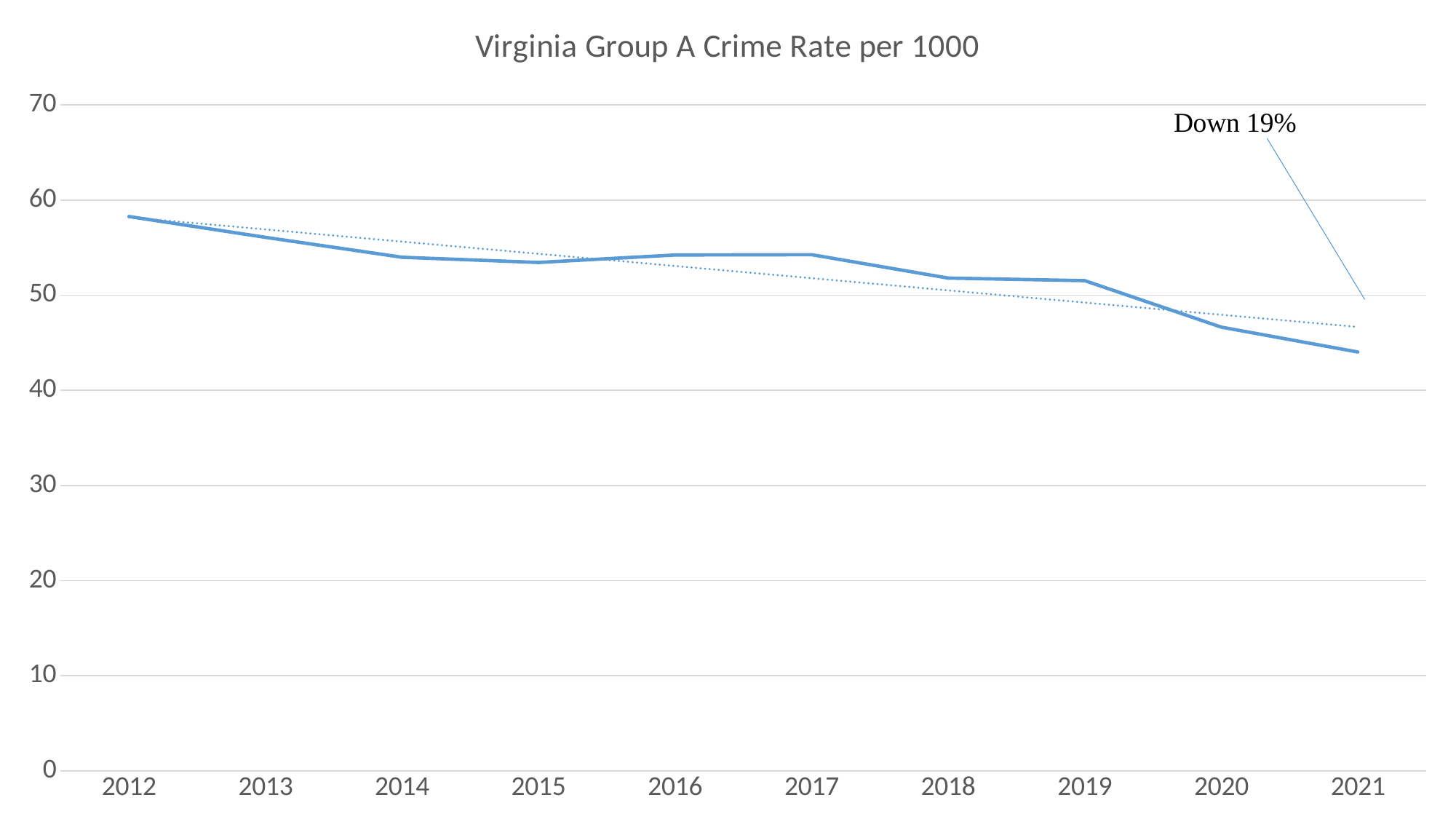
What percentage change does the annotation on the chart state? Down 19% Which year has the highest crime rate? 2012 Which year has the higher crime rate, 2014 or 2018? 2014 What kind of chart is shown on the slide? line chart Which year has the lowest crime rate? 2021 Do the values generally rise or fall from 2012 to 2021? fall Is the value for 2020 greater or less than 50? less Is the value for 2012 greater or less than 50? greater Is the value for 2017 greater or less than 60? less How many years are plotted along the x axis? 10 What is the title of the chart? Virginia Group A Crime Rate per 1000